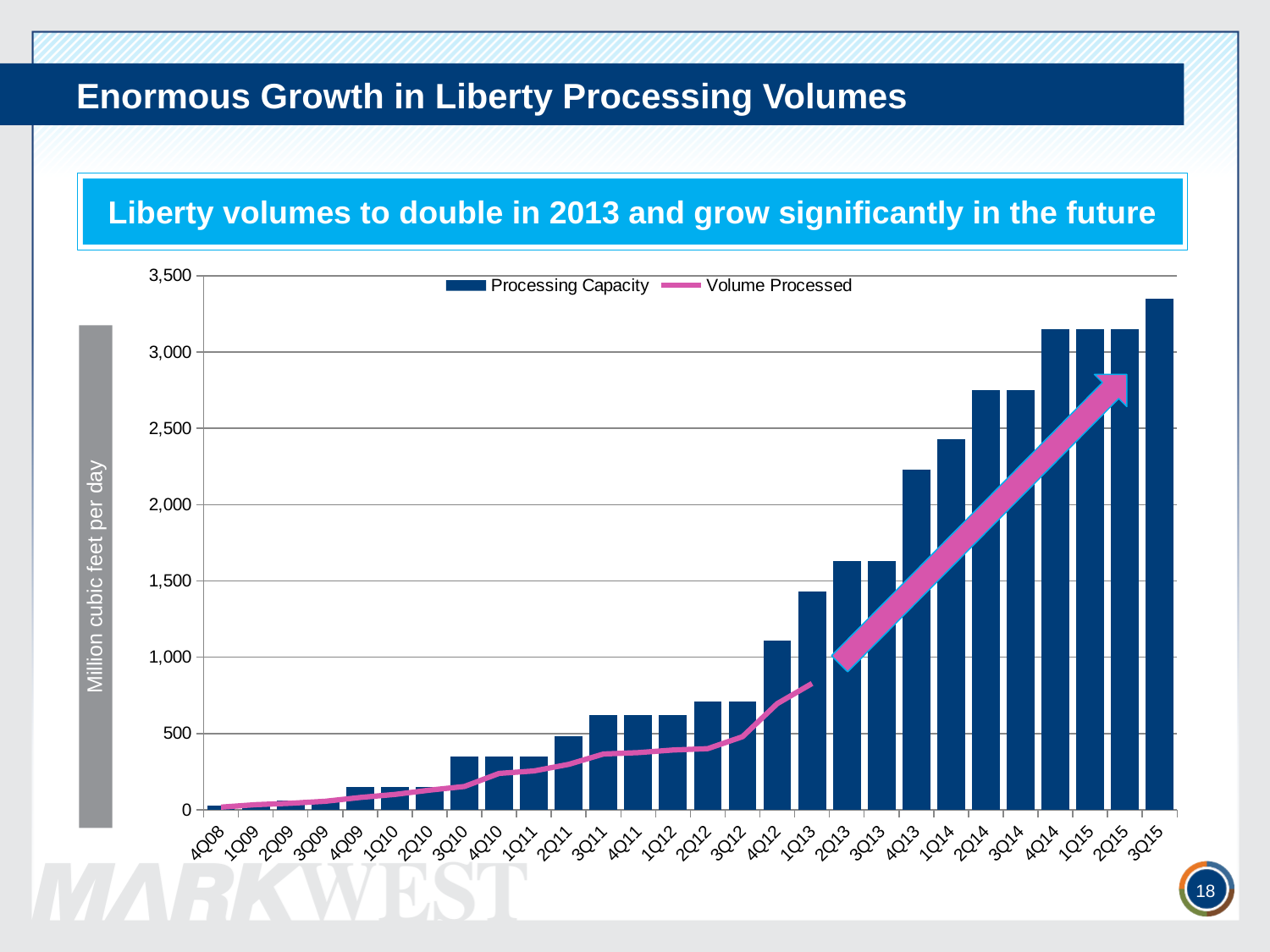
Is the Processing Capacity for 2Q14 greater or less than 3,000? less How many series does the legend list? 2 What is the label on the vertical axis? Million cubic feet per day Do the Processing Capacity bars generally rise or fall from 4Q08 to 3Q15? rise Which quarter has the highest Processing Capacity bar? 3Q15 Is the Processing Capacity for 4Q13 greater or less than 2,000? greater What kind of chart is shown on the slide? bar and line chart Is the Processing Capacity for 3Q15 greater or less than 3,000? greater What are the two series named in the legend? Processing Capacity and Volume Processed Which quarter has the lowest Processing Capacity bar? 4Q08 and 1Q09 (tied) Which is larger, the Processing Capacity for 2Q13 or for 1Q13? 2Q13 How many quarters are shown along the x axis? 28